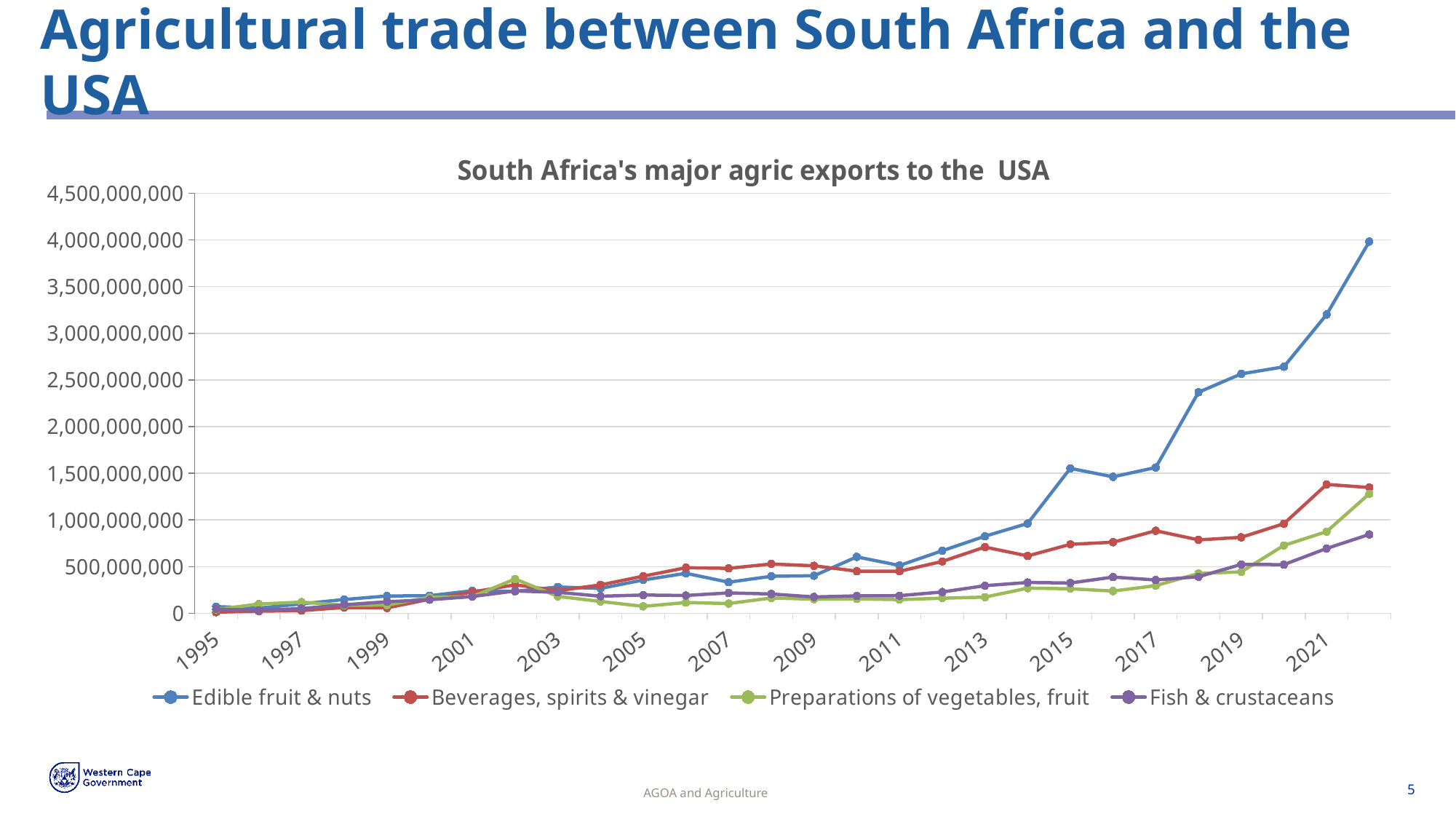
Is the value for Preparations of vegetables, fruit in 2021 greater or less than 1,000,000,000? less Which series has the highest value in 2021? Edible fruit & nuts What kind of chart is shown on the slide? Line chart How many year labels are shown on the x axis? 14 Is the value for Edible fruit & nuts in 2013 greater or less than 1,000,000,000? less Does the Edible fruit & nuts series generally rise or fall from 1995 to 2021? rise In 2021, which is larger: Beverages, spirits & vinegar or Preparations of vegetables, fruit? Beverages, spirits & vinegar Is the value for Beverages, spirits & vinegar in 2021 greater or less than 1,000,000,000? greater Which series has the lowest value in 2021? Fish & crustaceans How many series does the legend list? 4 What is the title of the chart? South Africa's major agric exports to the USA